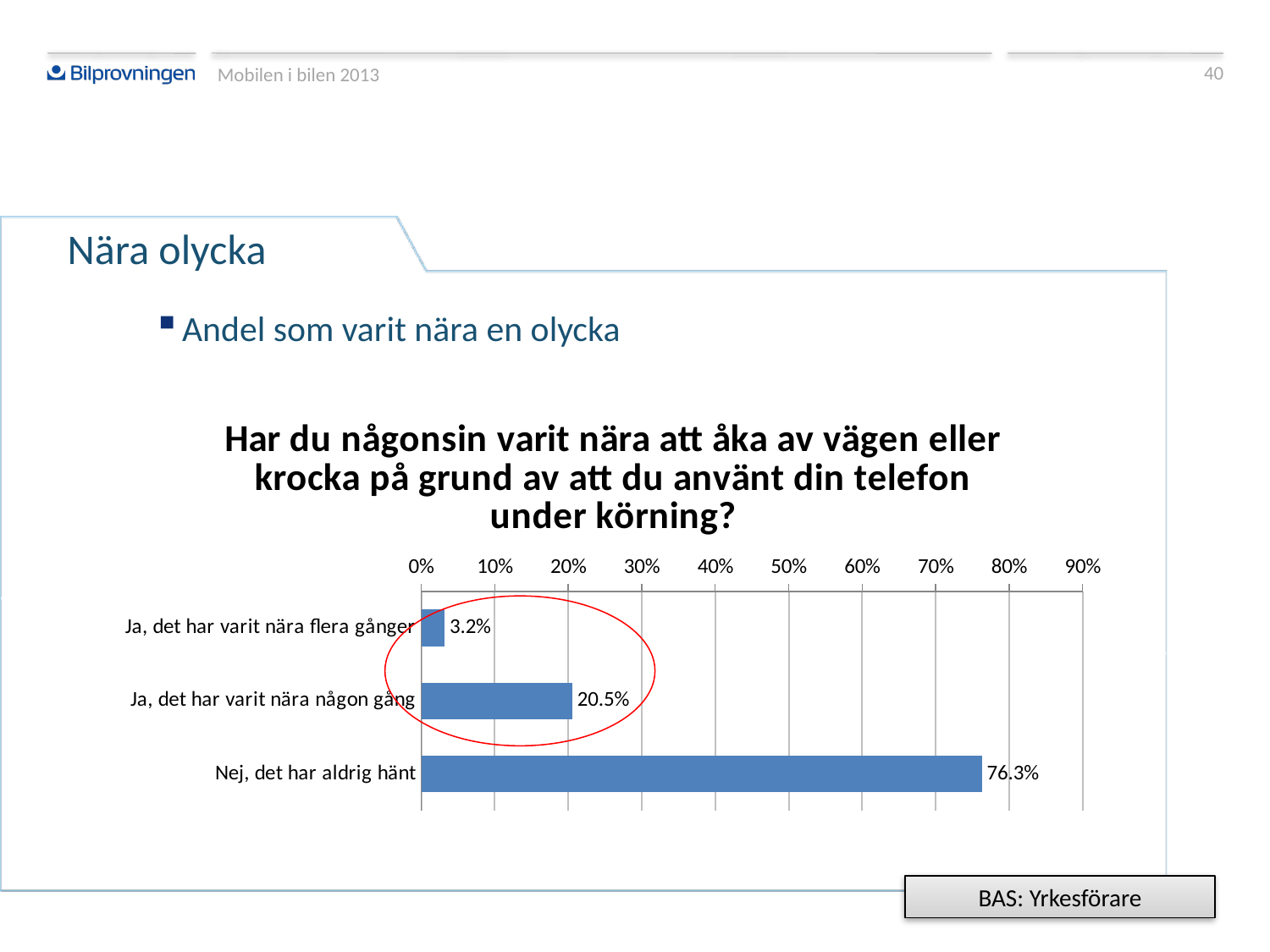
What kind of chart is shown on the slide? bar chart What is the value for "Ja, det har varit nära flera gånger"? 3.2% Which category has the highest value? Nej, det har aldrig hänt Is the value for "Nej, det har aldrig hänt" greater or less than 70%? greater What is the difference between the values for "Ja, det har varit nära någon gång" and "Ja, det har varit nära flera gånger"? 17.3% Which is larger: the value for "Ja, det har varit nära någon gång" or "Ja, det har varit nära flera gånger"? Ja, det har varit nära någon gång How many categories are shown in the chart? 3 Which category has the lowest value? Ja, det har varit nära flera gånger What is the difference between the values for "Nej, det har aldrig hänt" and "Ja, det har varit nära någon gång"? 55.8% What is the value for "Ja, det har varit nära någon gång"? 20.5% What is the value for "Nej, det har aldrig hänt"? 76.3% What is the title of the chart? Har du någonsin varit nära att åka av vägen eller krocka på grund av att du använt din telefon under körning?